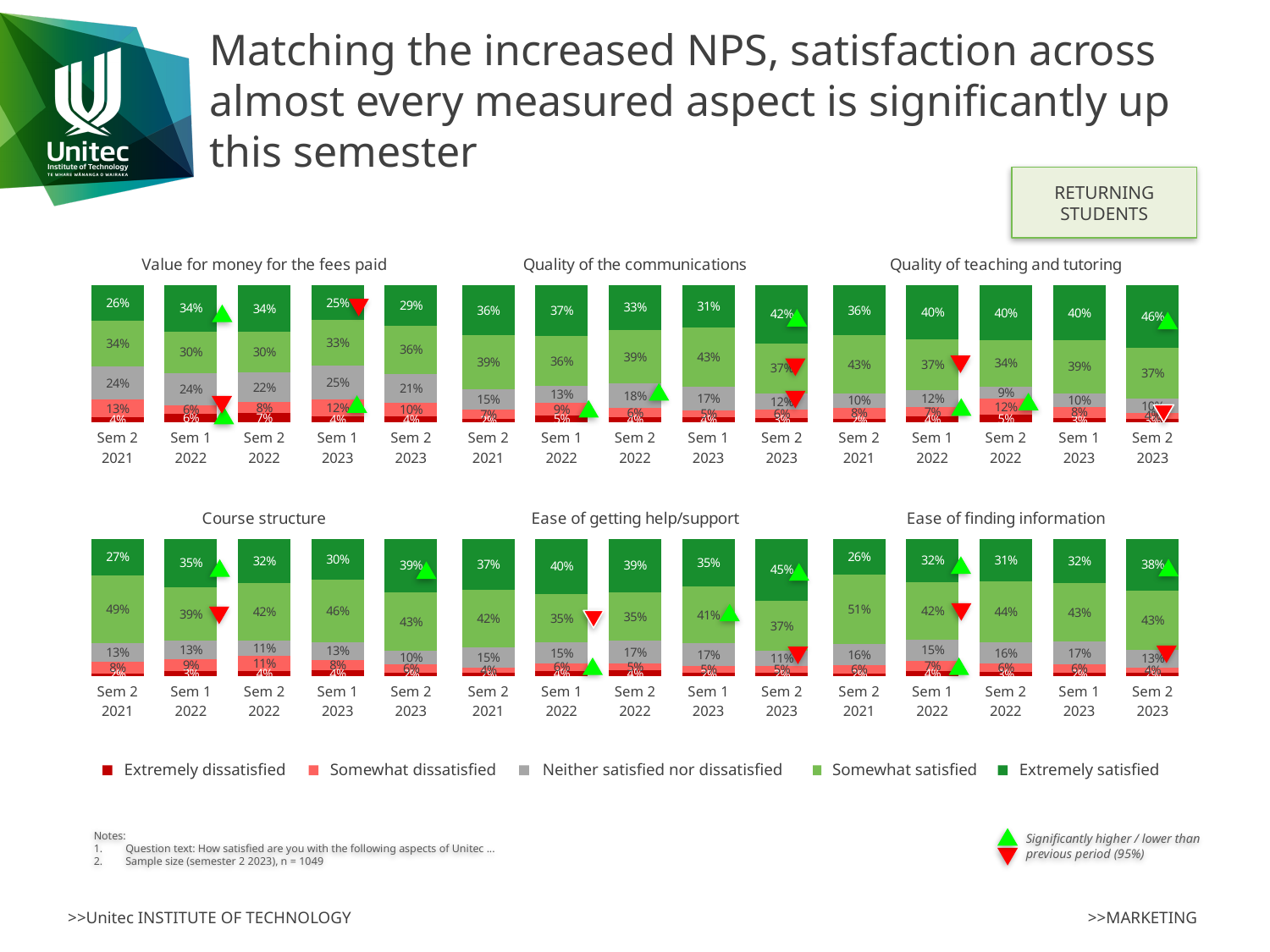
In the 'Ease of finding information' chart, what is the Extremely satisfied value for Sem 2 2023? 38% In the 'Quality of teaching and tutoring' chart, what is the Neither satisfied nor dissatisfied value for Sem 1 2022? 12% In the 'Quality of teaching and tutoring' chart, which semester has the highest Extremely satisfied value? Sem 2 2023 In the 'Quality of the communications' chart, what is the Somewhat satisfied value for Sem 1 2023? 43% How many series does the legend list? 5 What kind of chart is 'Quality of the communications'? Stacked bar chart In the 'Value for money for the fees paid' chart, what is the Extremely satisfied value for Sem 2 2023? 29% In the 'Ease of finding information' chart, which is larger: the Somewhat satisfied value for Sem 2 2021 or for Sem 2 2023? Sem 2 2021 In the 'Course structure' chart, which semester has the lowest Extremely satisfied value? Sem 2 2021 In the 'Ease of getting help/support' chart, what is the difference between the Extremely satisfied values for Sem 2 2023 and Sem 1 2023? 10% How many semesters are shown in the 'Course structure' chart? 5 Which legend entry is shown in dark green? Extremely satisfied